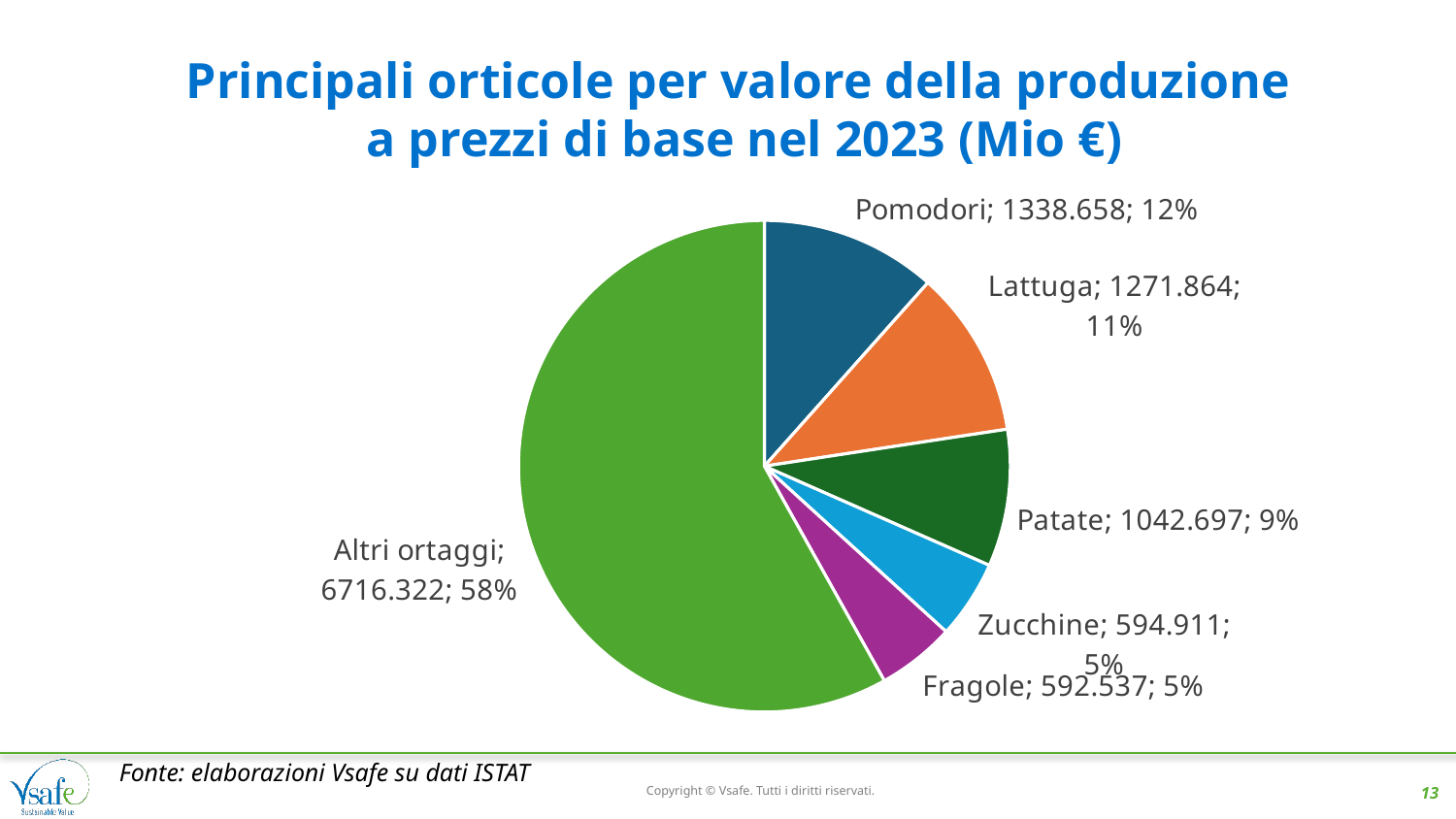
What share of the pie does Lattuga represent? 11% Which category has the largest slice of the pie? Altri ortaggi Which has a larger value, Zucchine or Fragole? Zucchine What is the title of the chart? Principali orticole per valore della produzione a prezzi di base nel 2023 (Mio €) What is the production value for Patate? 1042.697 What is the production value for Pomodori? 1338.658 What share of the pie does Altri ortaggi represent? 58% What is the production value for Zucchine? 594.911 How many categories are shown in the pie chart? 6 What is the difference between the values for Pomodori and Lattuga? 66.794 Which category has the smallest value in the pie chart? Fragole What type of chart is shown on the slide? Pie chart